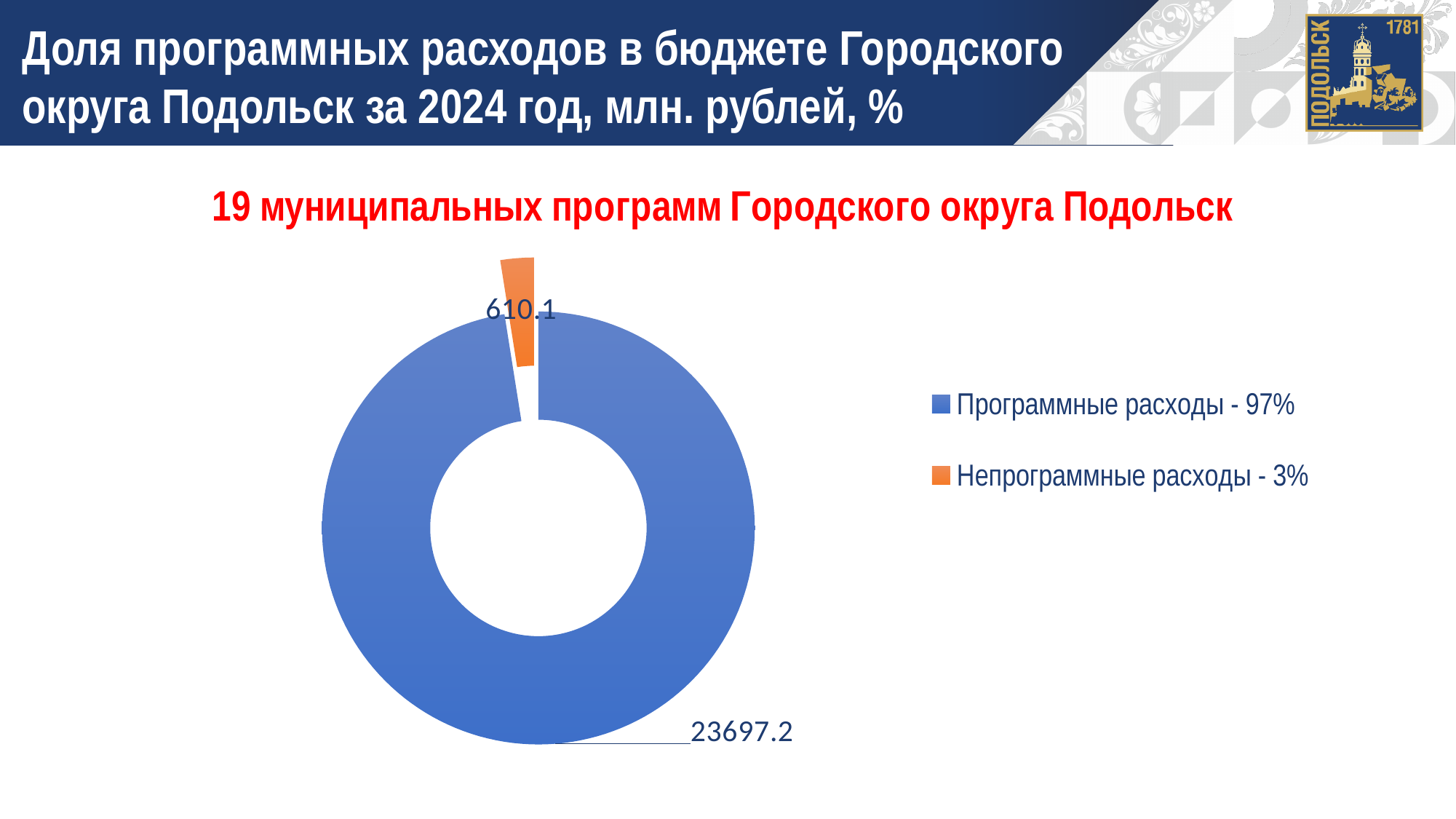
What colour is the slice for Непрограммные расходы? Orange What share of the total does Программные расходы represent, according to the legend? 97% Which category has the largest value? Программные расходы Which category has the smallest value? Непрограммные расходы What is the value for Непрограммные расходы? 610.1 How many categories does the chart show? 2 What is the difference between Программные расходы and Непрограммные расходы? 23087.1 What share of the total does Непрограммные расходы represent, according to the legend? 3% What is the total of the two values shown on the chart? 24307.3 What kind of chart is shown on the slide? Pie chart (doughnut) What is the value for Программные расходы? 23697.2 Which is larger, Программные расходы or Непрограммные расходы? Программные расходы